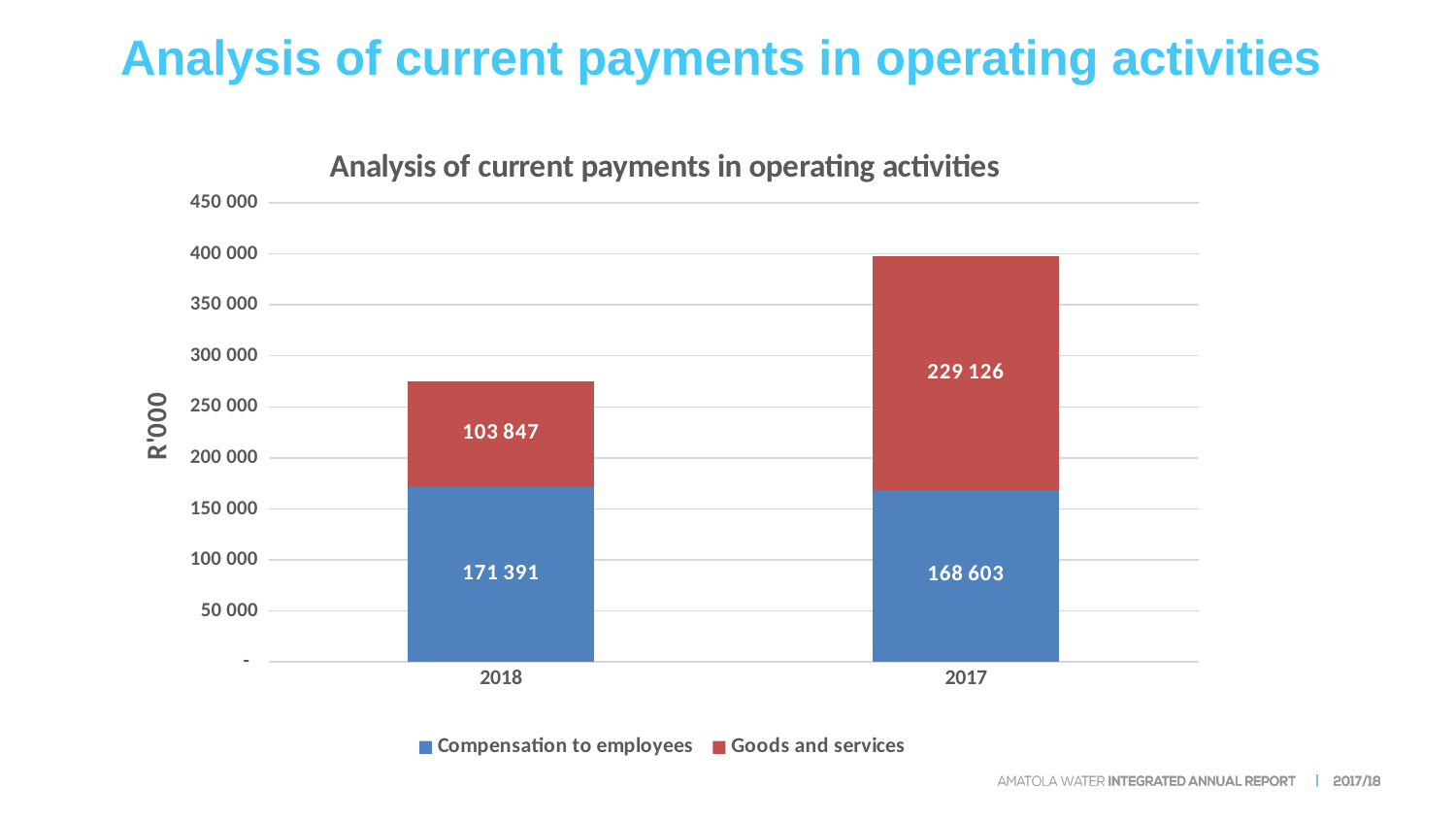
How many series does the legend list? 2 What kind of chart is shown? Stacked bar chart What is the value for Goods and services in 2017? 229 126 What is the value for Compensation to employees in 2017? 168 603 What is the difference between Compensation to employees in 2018 and in 2017? 2 788 What is the total of the stacked bar for 2017? 397 729 Is Goods and services in 2017 larger or smaller than Compensation to employees in 2017? larger What is the value for Compensation to employees in 2018? 171 391 What is the difference between Goods and services in 2017 and in 2018? 125 279 What is the total of the stacked bar for 2018? 275 238 What is the value for Goods and services in 2018? 103 847 Which year has the higher value for Goods and services? 2017